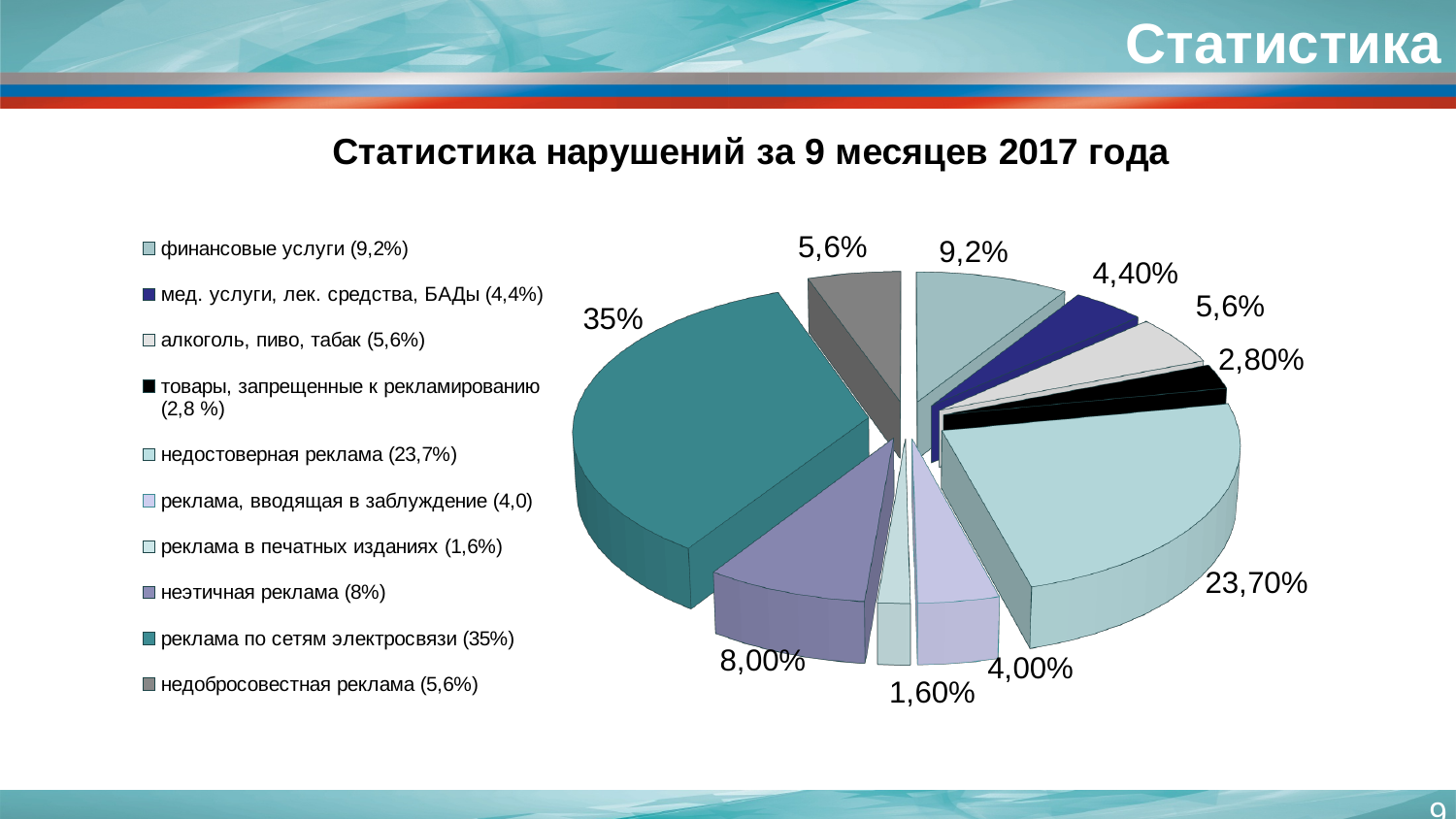
What share of the pie does реклама по сетям электросвязи take? 35% Which category has the largest slice in the pie chart? реклама по сетям электросвязи What value is shown for неэтичная реклама? 8,00% Which is larger: недостоверная реклама or неэтичная реклама? недостоверная реклама How many categories (slices) does the pie chart have? 10 Which category has the smallest slice in the pie chart? реклама в печатных изданиях What is the title of the chart? Статистика нарушений за 9 месяцев 2017 года What value is shown for финансовые услуги? 9,2% What is the difference between the values for реклама по сетям электросвязи (35%) and недостоверная реклама (23,70%)? 11,3% What type of chart is shown on the slide? pie chart What value is shown for товары, запрещенные к рекламированию? 2,80% What value is shown for недостоверная реклама? 23,70%